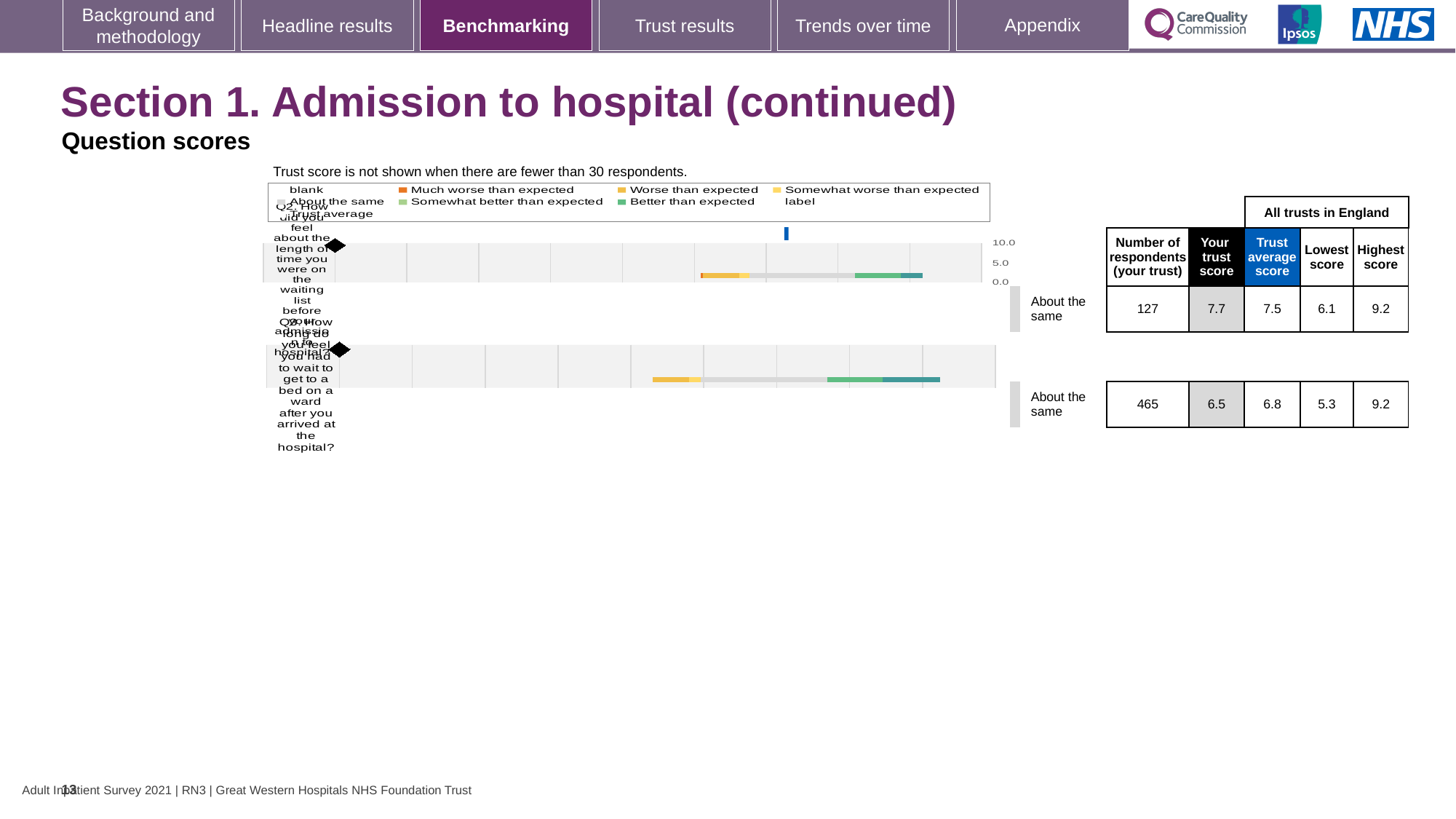
How many questions (bars) are plotted on the slide? 2 What benchmark category is shown next to the Q2 bar? About the same For Q2, what is the difference between the highest score and the lowest score across all trusts in England? 3.1 What is the trust score for Q2 (length of time on the waiting list before admission)? 7.7 How many respondents answered Q3 at this trust? 465 Is the trust score for Q3 greater or less than 5.0? greater What kind of chart is used to show the question scores on this slide? bar chart For Q3, which is larger: your trust score or the trust average score? Trust average score What is the trust average score for Q2? 7.5 For Q2, which is larger: your trust score or the trust average score? Your trust score For Q3, what is the difference between the highest score and the lowest score across all trusts in England? 3.9 What is the trust score for Q3 (wait to get to a bed on a ward after arriving at the hospital)? 6.5